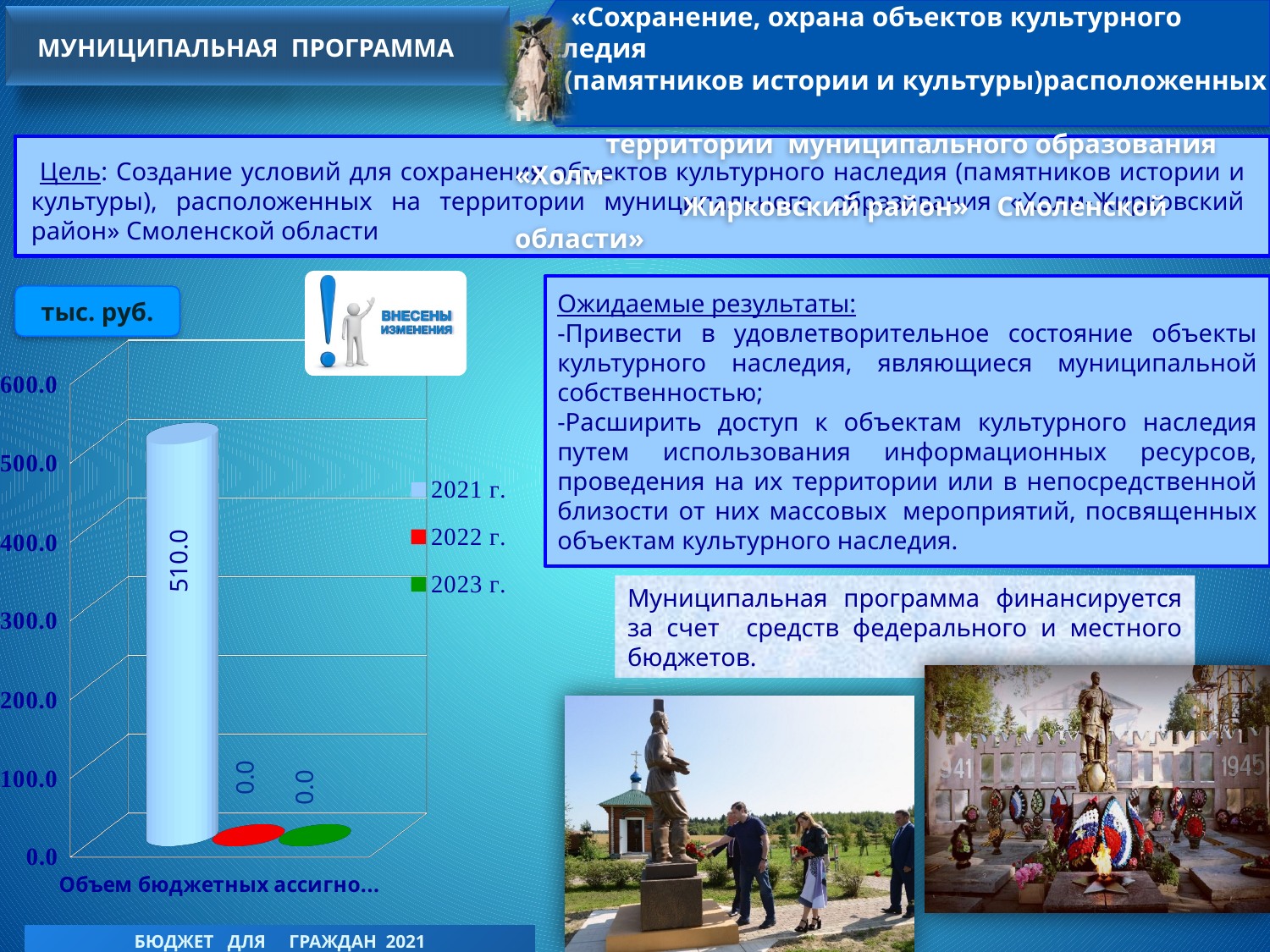
What is the value for 2023 г. on the chart? 0.0 Is the value for 2021 г. greater or less than 500.0? greater What kind of chart is shown on the slide? bar chart How many series does the chart legend list? 3 What unit of measurement is indicated for the chart values? тыс. руб. What colour is used for the 2022 г. series in the legend? red What is the value for 2021 г. on the chart? 510.0 What is the difference between the values for 2021 г. and 2022 г.? 510.0 Which is larger, the value for 2021 г. or the value for 2023 г.? 2021 г. Which year has the highest value on the chart? 2021 г. Is the value for 2021 г. greater or less than 600.0? less What is the value for 2022 г. on the chart? 0.0